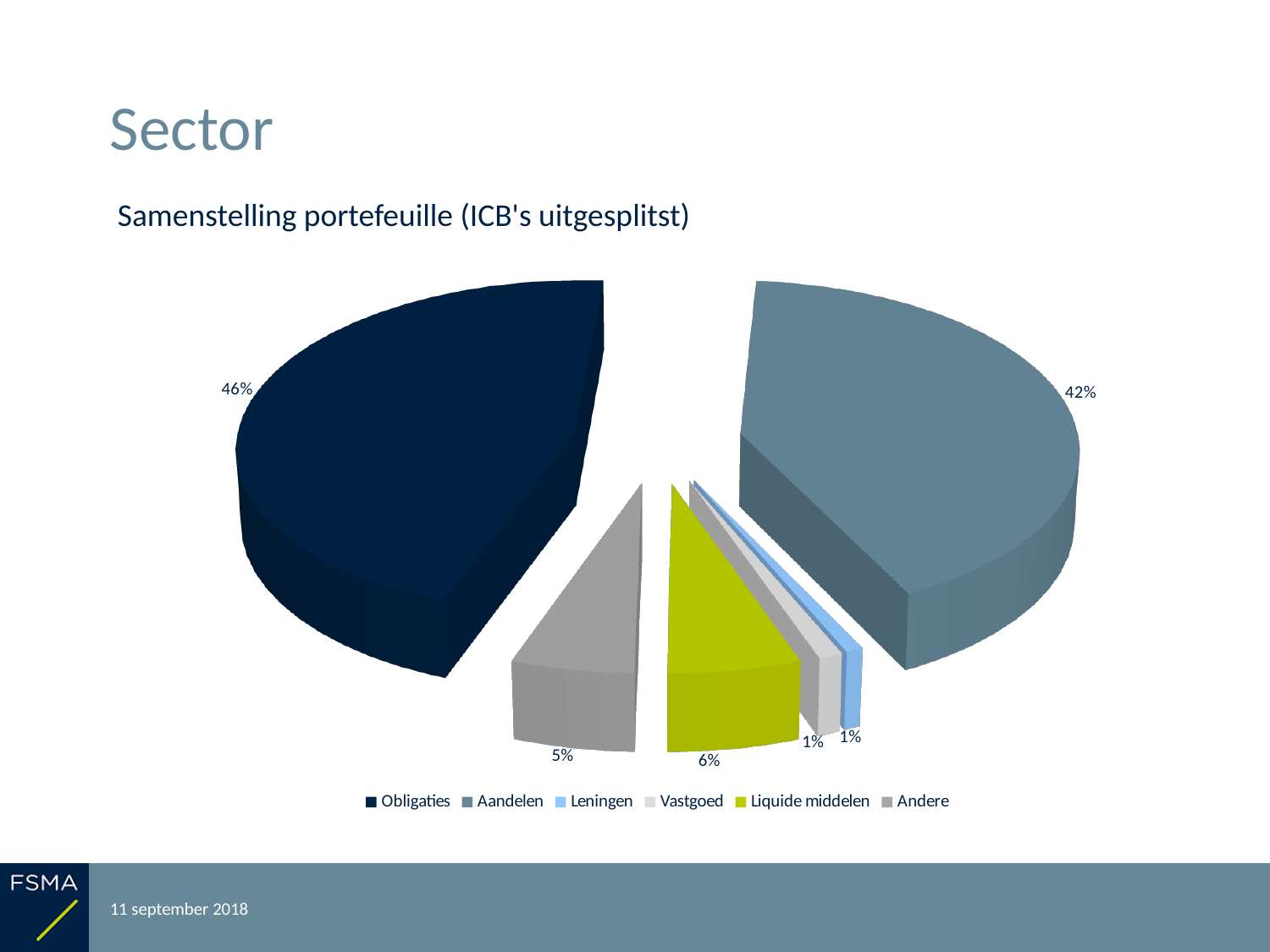
What share of the portfolio is Leningen? 1% What is the title of the chart? Samenstelling portefeuille (ICB's uitgesplitst) What share of the portfolio is Andere? 5% What is the difference in percentage points between Obligaties and Aandelen? 4 What share of the portfolio is Liquide middelen? 6% How many categories does the pie chart show? 6 What share of the portfolio is Obligaties? 46% What is the combined share of Obligaties and Aandelen? 88% Which category has the largest slice of the pie? Obligaties Which is larger, the share for Liquide middelen or the share for Andere? Liquide middelen What share of the portfolio is Aandelen? 42% What type of chart is shown on the slide? Pie chart